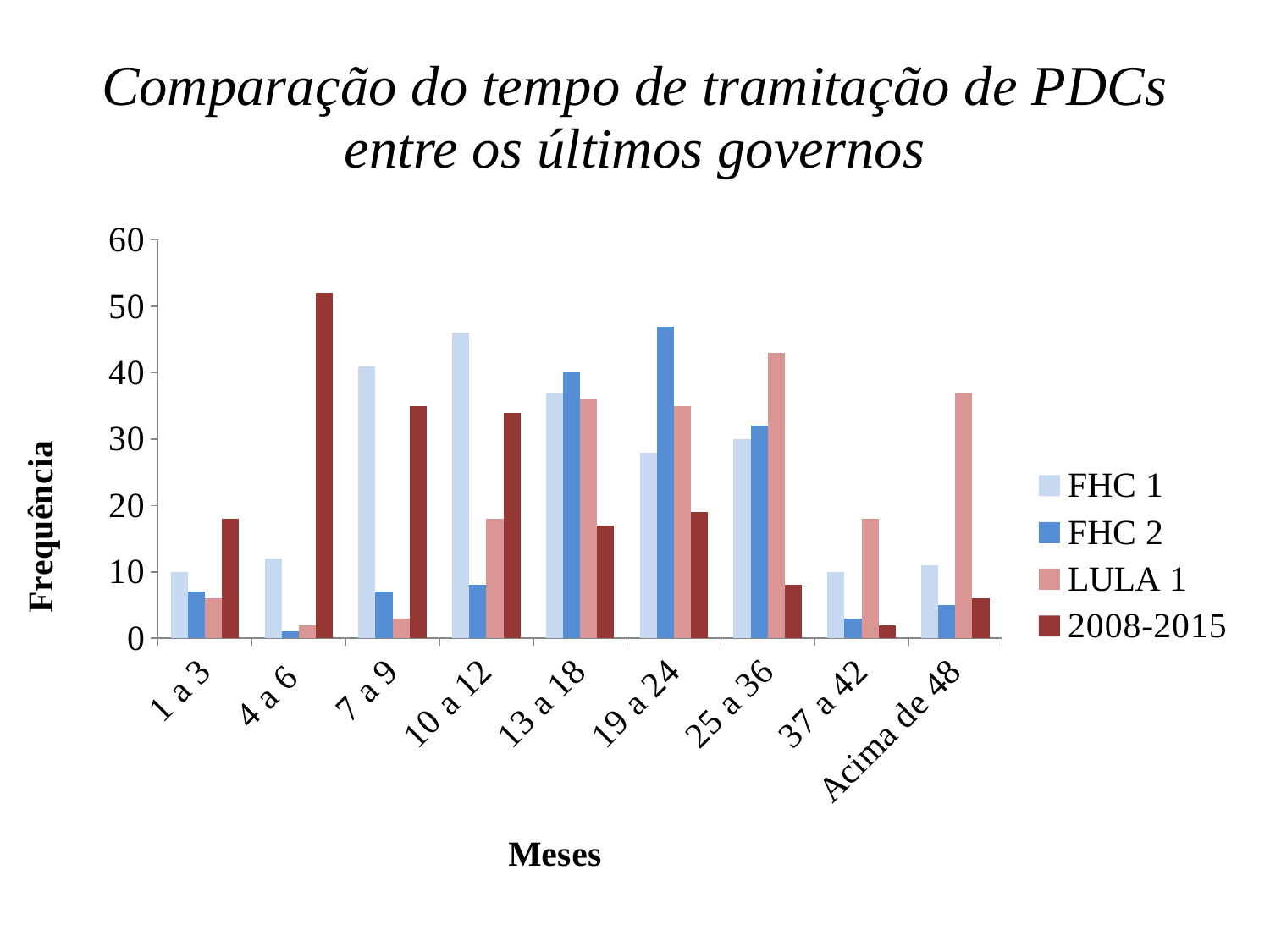
In the 7 a 9 category, which is larger: FHC 1 or LULA 1? FHC 1 For the LULA 1 series, which category has the highest value? 25 a 36 Is the value for FHC 2 in the 4 a 6 category greater or less than 10? less What is the label of the vertical axis? Frequência What kind of chart is shown on the slide? bar chart For the 2008-2015 series, which category has the highest value? 4 a 6 Is the value for 2008-2015 in the 4 a 6 category greater or less than 50? greater How many categories are shown on the x axis? 9 For the FHC 2 series, which category has the highest value? 19 a 24 In the Acima de 48 category, which is larger: LULA 1 or 2008-2015? LULA 1 How many series does the legend list? 4